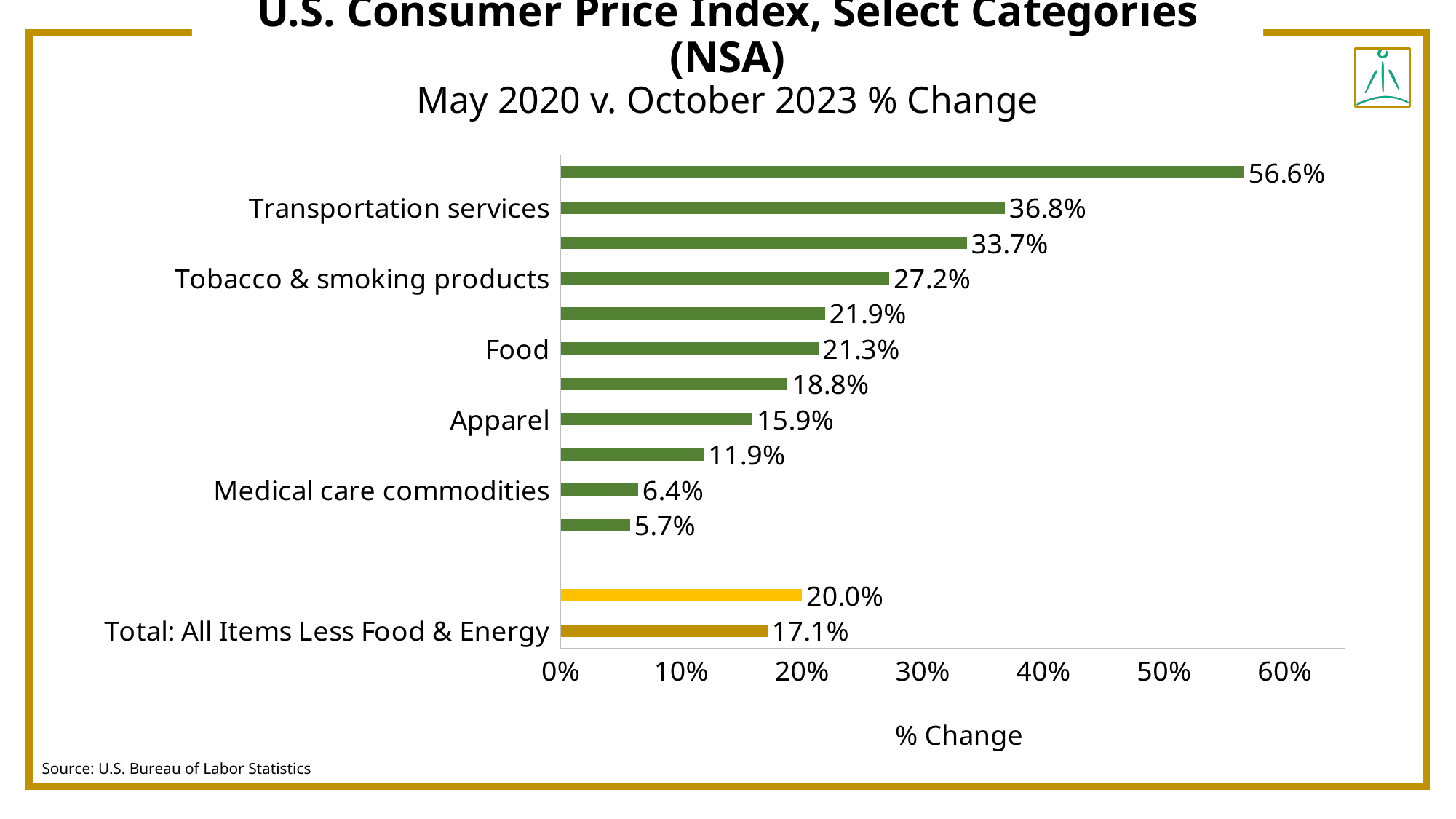
What kind of chart is shown on the slide? Bar chart How many percentage points higher is Transportation services than Food? 15.5 percentage points What is the smallest % change value shown on the chart? 5.7% How many bars are plotted on the chart? 13 What is the % change for Transportation services? 36.8% What is the % change for Tobacco & smoking products? 27.2% What is the % change for Food? 21.3% What is the % change for Total: All Items Less Food & Energy? 17.1% What is the % change for Apparel? 15.9% Which has a larger % change, Food or Apparel? Food What is the largest % change value shown on the chart? 56.6% Is the value for Medical care commodities greater or less than 10%? less